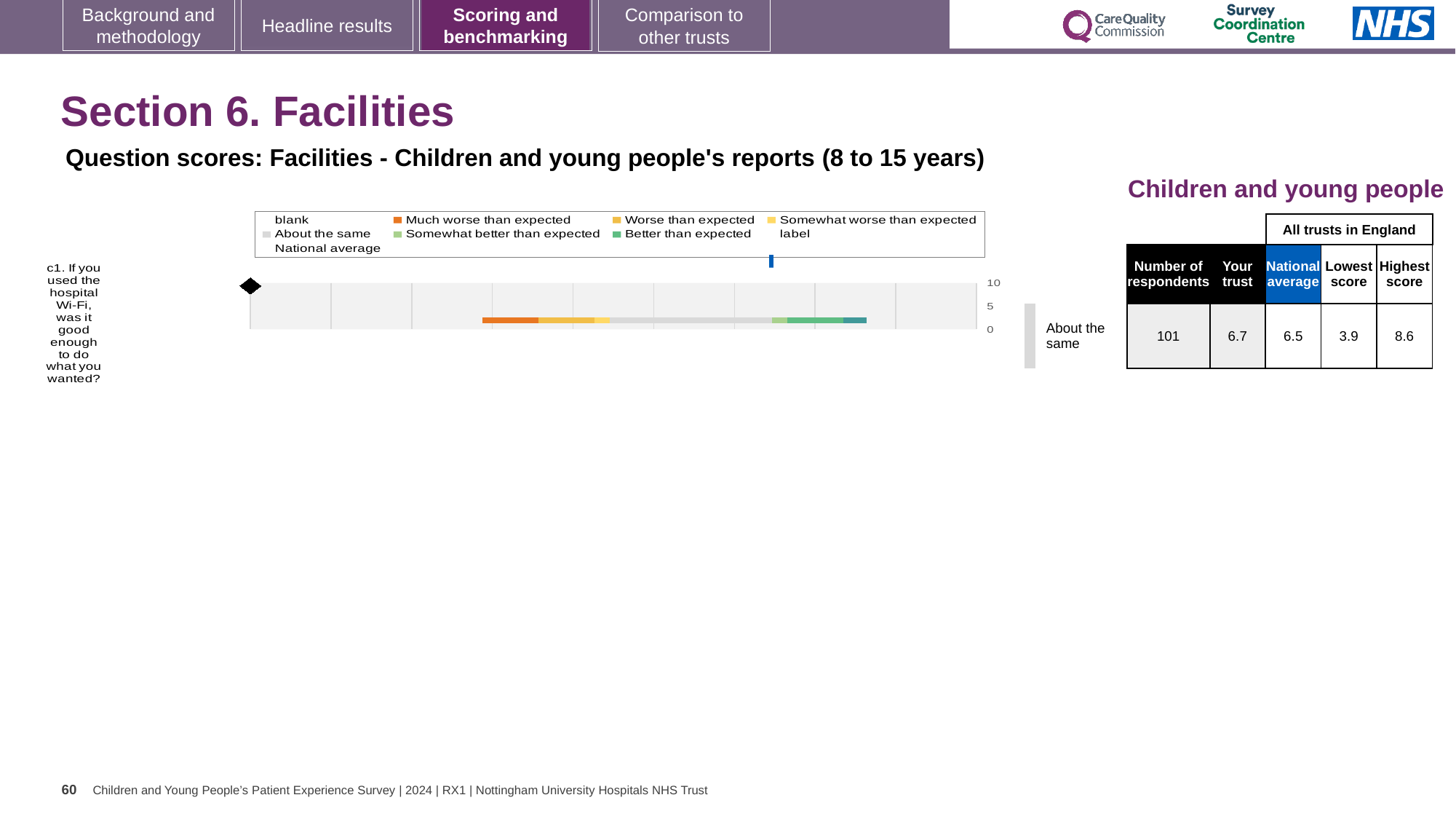
According to the table, what is the national average score for question c1? 6.5 What is the difference between the 'Your trust' score and the national average for question c1? 0.2 Which survey question is plotted in the chart? c1. If you used the hospital Wi-Fi, was it good enough to do what you wanted? How many respondents answered question c1? 101 How many survey questions (categories) are plotted in the chart? 1 According to the table, what is the highest score among all trusts in England for question c1? 8.6 According to the table, what is the 'Your trust' score for question c1? 6.7 What benchmark category is the trust's result for question c1 placed in? About the same According to the table, what is the lowest score among all trusts in England for question c1? 3.9 Which is larger for question c1: the 'Your trust' score or the national average? Your trust In the chart legend, which colour represents 'Much worse than expected'? orange What kind of chart is shown on the slide? bar chart